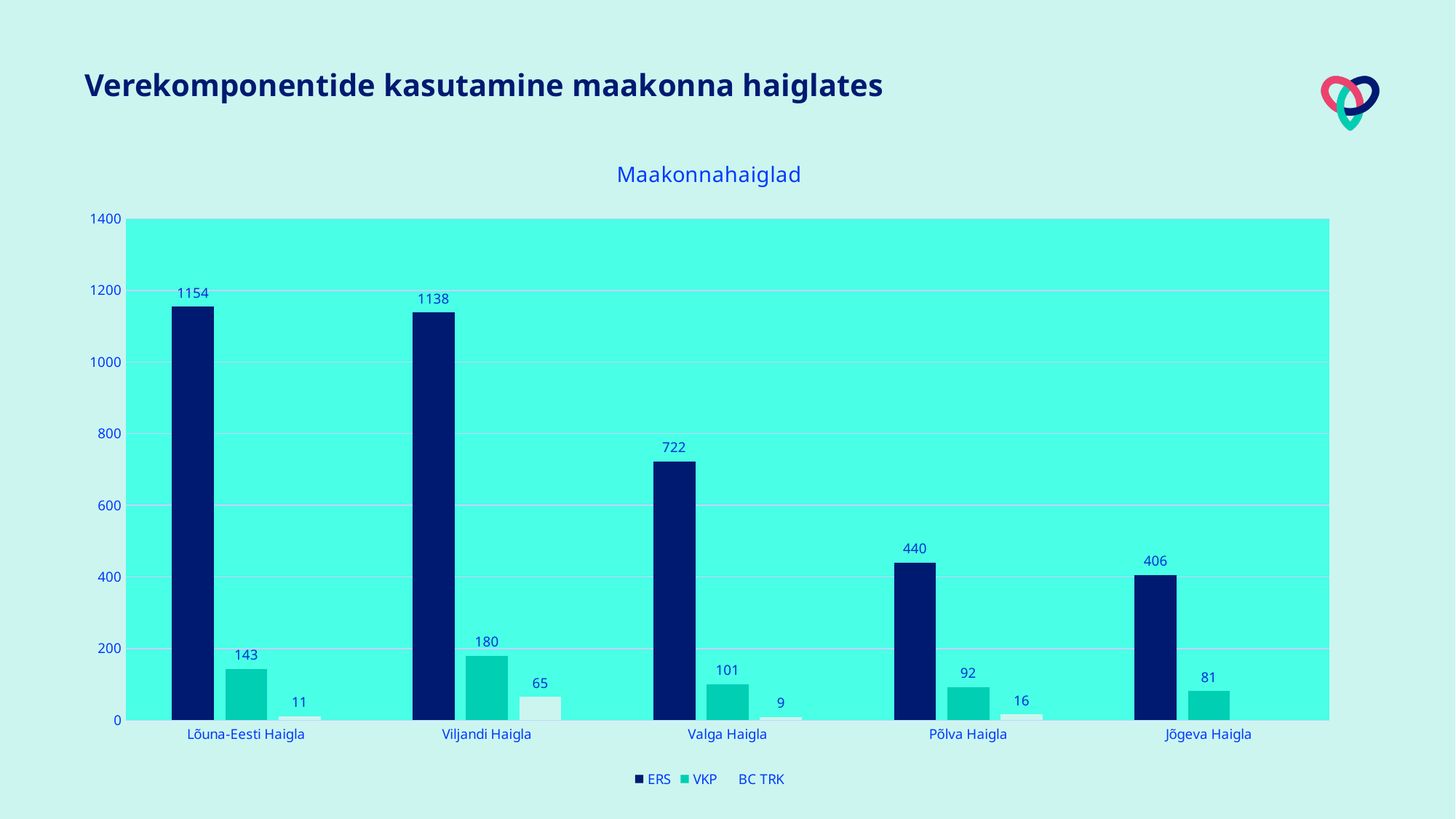
What is the ERS value for Valga Haigla? 722 What kind of chart is shown on the slide? bar chart Which hospital has the lowest VKP value? Jõgeva Haigla Which is larger, the VKP value for Valga Haigla or the VKP value for Põlva Haigla? Valga Haigla Is the ERS value for Põlva Haigla greater or less than 600? less How many series does the legend list? 3 What is the difference between the ERS values of Lõuna-Eesti Haigla and Viljandi Haigla? 16 What is the title of the chart? Maakonnahaiglad What is the BC TRK value for Põlva Haigla? 16 What is the VKP value for Viljandi Haigla? 180 How many hospitals are shown on the x axis? 5 Which hospital has the highest ERS value? Lõuna-Eesti Haigla